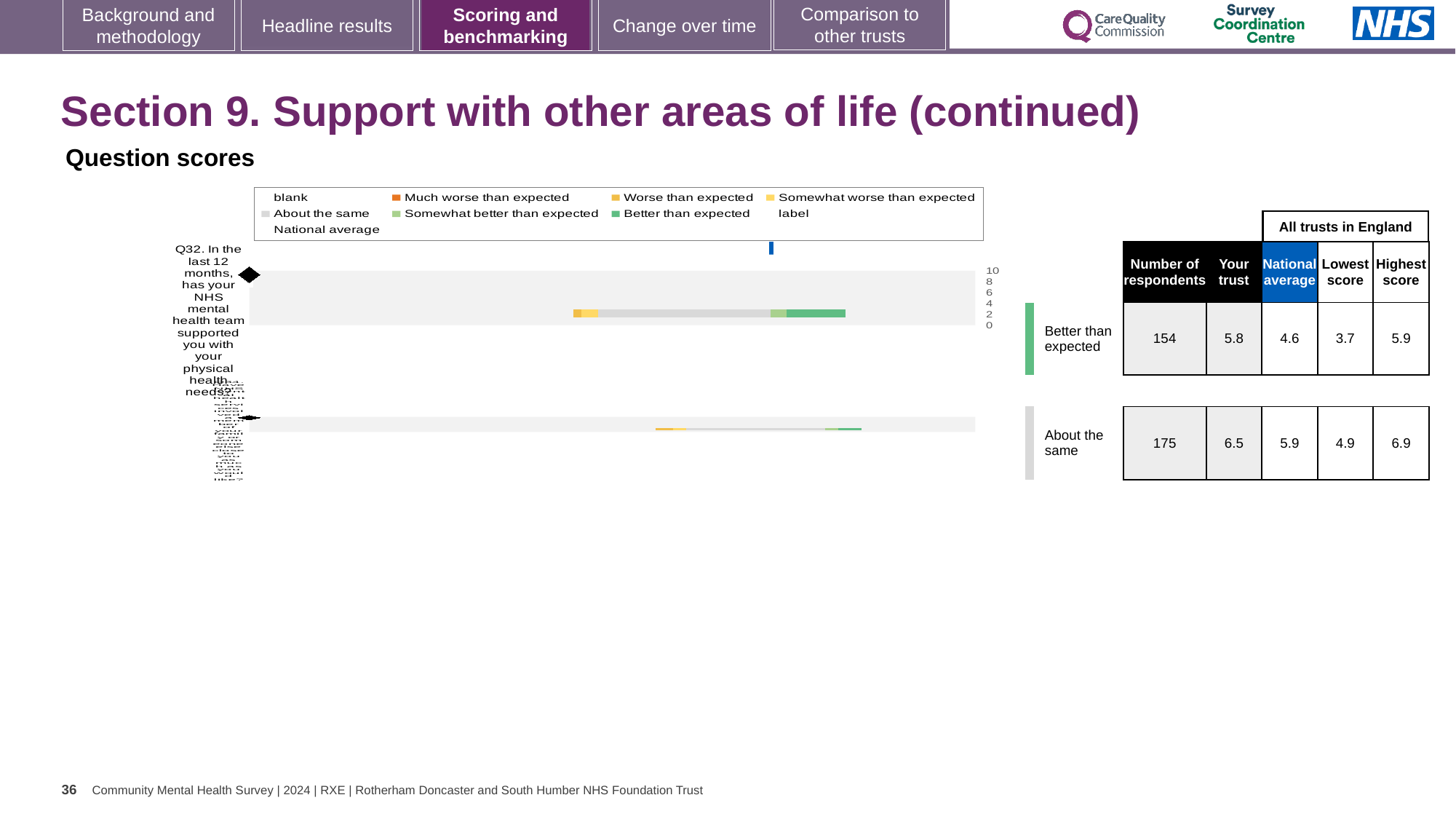
What benchmark category is the second (lower) question row placed in? About the same What is the 'Your trust' score for the second (lower) question row in the chart? 6.5 What is the lowest score among all trusts in England for Q32? 3.7 What is the highest score among all trusts in England for Q32? 5.9 How many question rows are plotted in the question scores chart? 2 How many respondents answered Q32 (support with physical health needs)? 154 What benchmark category is Q32 (support with physical health needs) placed in? Better than expected What is the difference between the 'Your trust' score and the national average for Q32? 1.2 What is the national average score for Q32 (support with physical health needs)? 4.6 Which is larger for the second (lower) question row: the 'Your trust' score or the national average? Your trust What kind of chart is used to show the question scores on this slide? bar chart What is the 'Your trust' score for Q32 (support with physical health needs)? 5.8